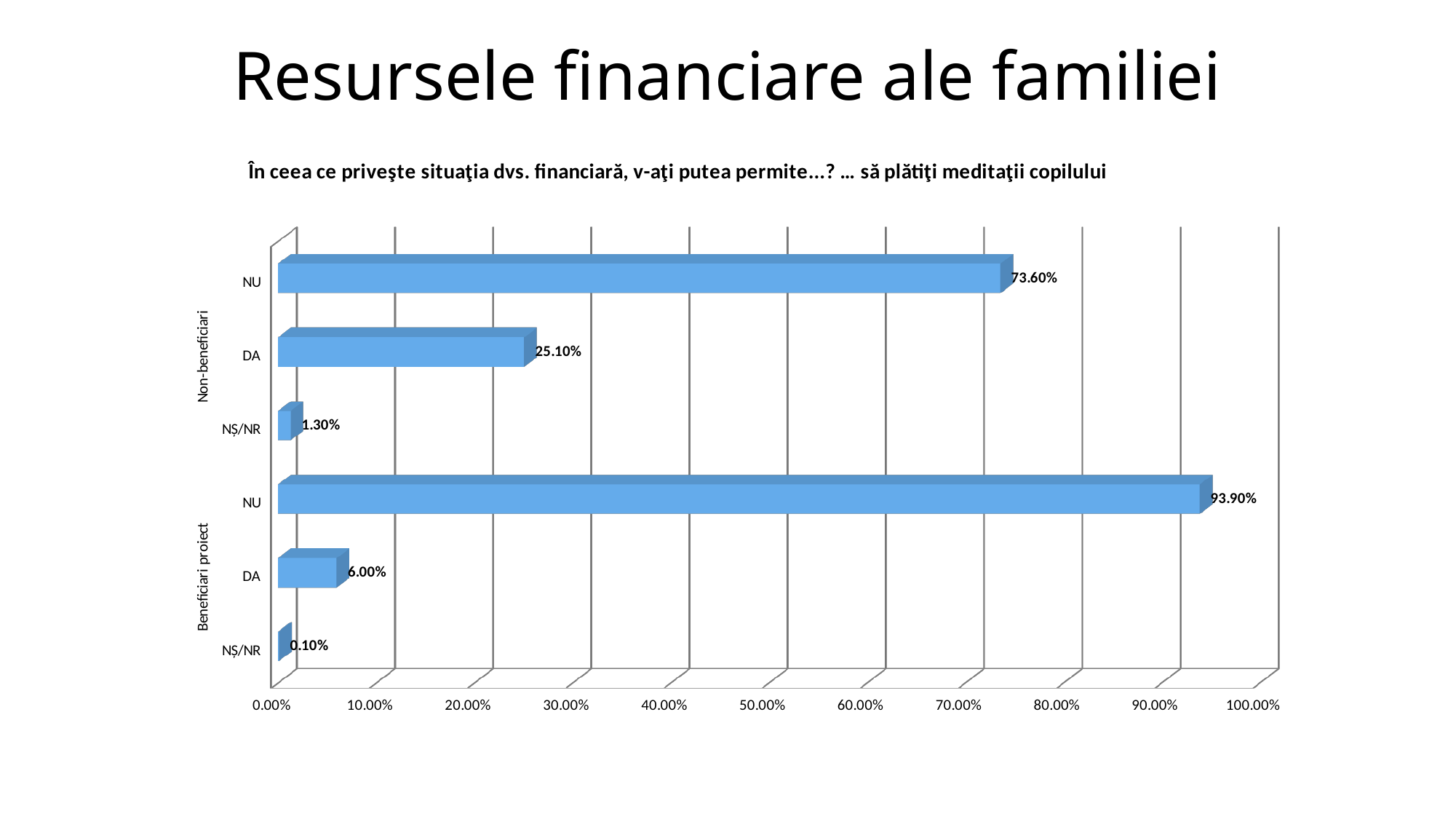
Is the value for DA in the Non-beneficiari group greater or less than 30.00%? less Which is larger: DA for Non-beneficiari or DA for Beneficiari proiect? DA for Non-beneficiari What is the value for NU in the Beneficiari proiect group? 93.90% What is the difference between the DA values for Non-beneficiari and Beneficiari proiect? 19.10% What is the difference between the NU values for Beneficiari proiect and Non-beneficiari? 20.30% Which bar has the lowest value on the chart? NȘ/NR (Beneficiari proiect) Which bar has the highest value on the chart? NU (Beneficiari proiect) How many bars are plotted on the chart? 6 What is the value for NȘ/NR in the Non-beneficiari group? 1.30% What kind of chart is shown on the slide? bar chart What is the value for DA in the Beneficiari proiect group? 6.00% What is the value for NU in the Non-beneficiari group? 73.60%